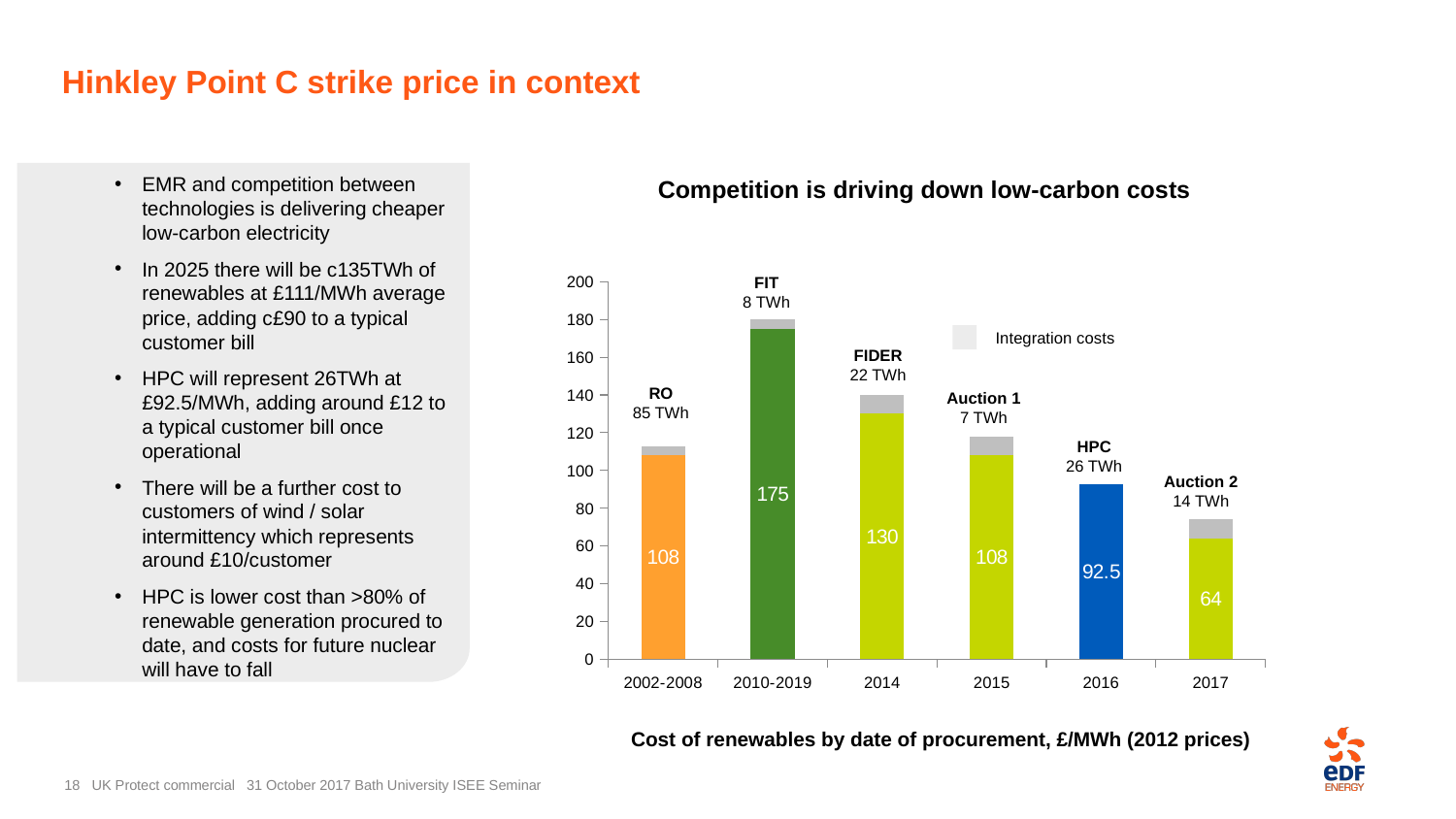
Which has a larger labelled value, the FIDER bar (2014) or the Auction 1 bar (2015)? FIDER What is the labelled cost value for the Auction 2 bar (2017)? 64 What is the labelled cost value for the HPC bar (2016)? 92.5 What is the difference between the labelled values for FIDER (130) and HPC (92.5)? 37.5 Is the total height of the FIT bar, including integration costs, greater or less than 160? greater Which category has the lowest labelled cost value? Auction 2 What is the labelled cost value for the FIT bar (2010-2019)? 175 What kind of chart is shown on the slide? Bar chart Which category has the highest labelled cost value? FIT What does the grey segment at the top of the bars represent, according to the legend? Integration costs How many bars are shown on the chart? 6 What is the difference between the labelled values for FIT (175) and Auction 2 (64)? 111